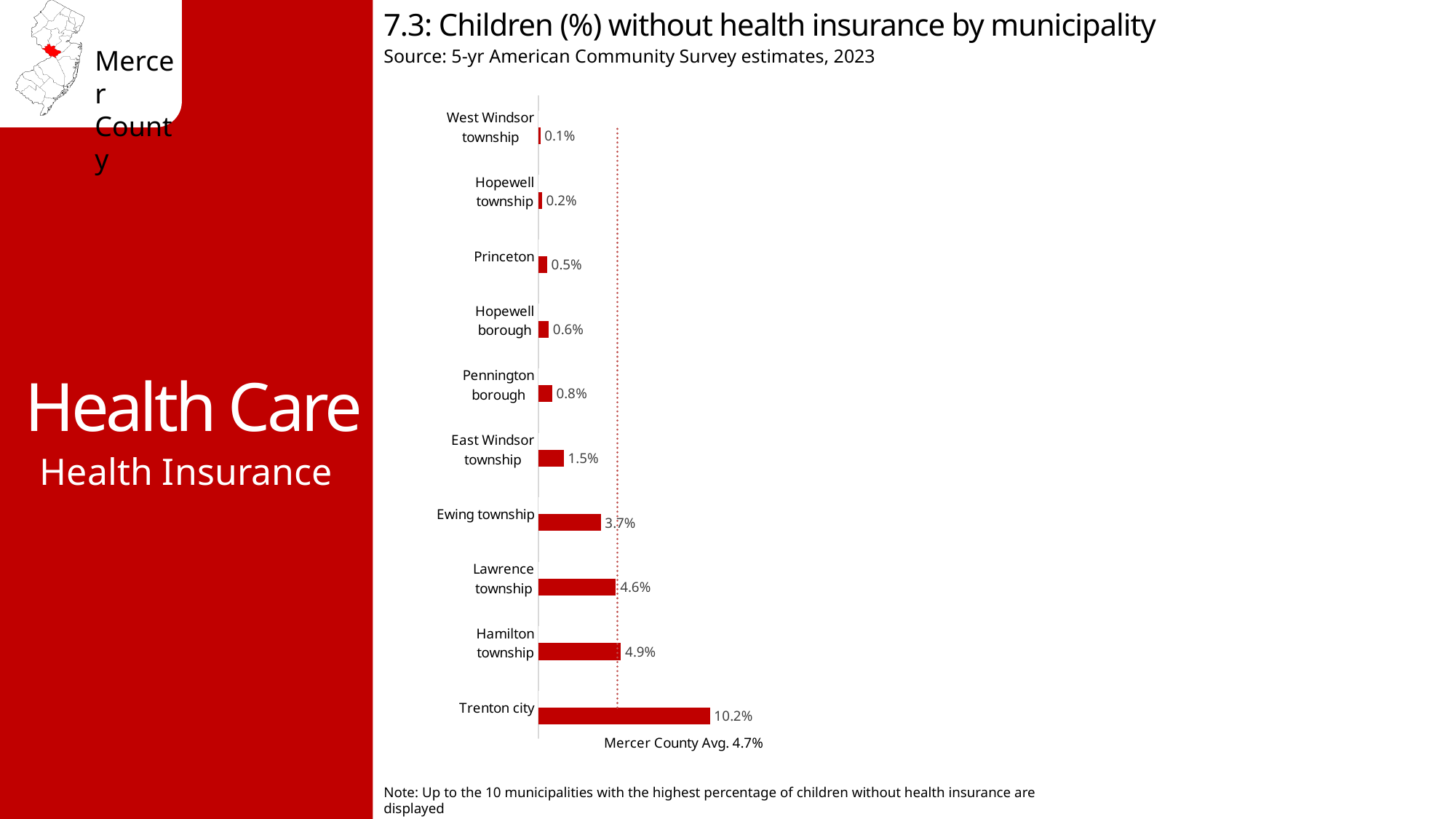
What is the Mercer County average shown by the dotted line? 4.7% What is the source of the data in the chart? 5-yr American Community Survey estimates, 2023 What is the value shown for Ewing township? 3.7% How many municipalities are shown in the chart? 10 What is the value shown for Princeton? 0.5% What percentage of children are without health insurance in Trenton city? 10.2% What is the difference between the values for Trenton city and Hamilton township? 5.3% Which municipality has the lowest percentage of children without health insurance? West Windsor township What is the difference between the values for Lawrence township and East Windsor township? 3.1% What kind of chart is shown on the slide? Bar chart Which has a higher value, Ewing township or Pennington borough? Ewing township Which municipality has the highest percentage of children without health insurance? Trenton city